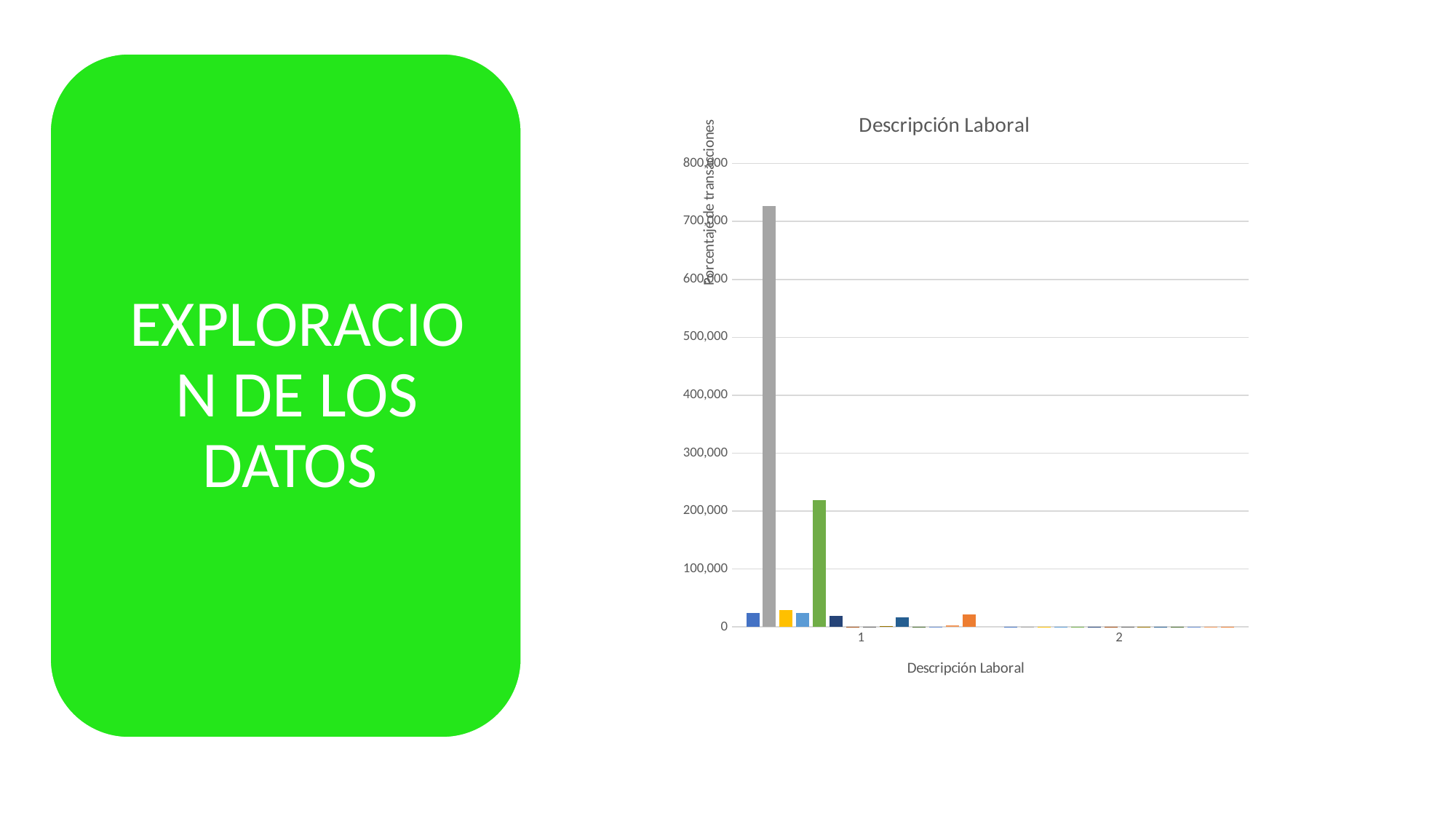
Is the value of the tallest bar in the chart greater or less than 800,000? less What is the title of the chart? Descripción Laboral Which x-axis category contains the tallest bar in the chart? 1 Which is larger in the chart, the gray bar or the green bar in category 1? the gray bar What kind of chart is shown on the slide? bar chart Is the value of the tallest bar in the chart greater or less than 700,000? greater How many categories are labelled on the x axis of the chart? 2 What is the label of the vertical axis of the chart? Porcentaje de transacciones Is the value of the second tallest (green) bar in the chart greater or less than 300,000? less What is the highest value shown on the vertical axis of the chart? 800,000